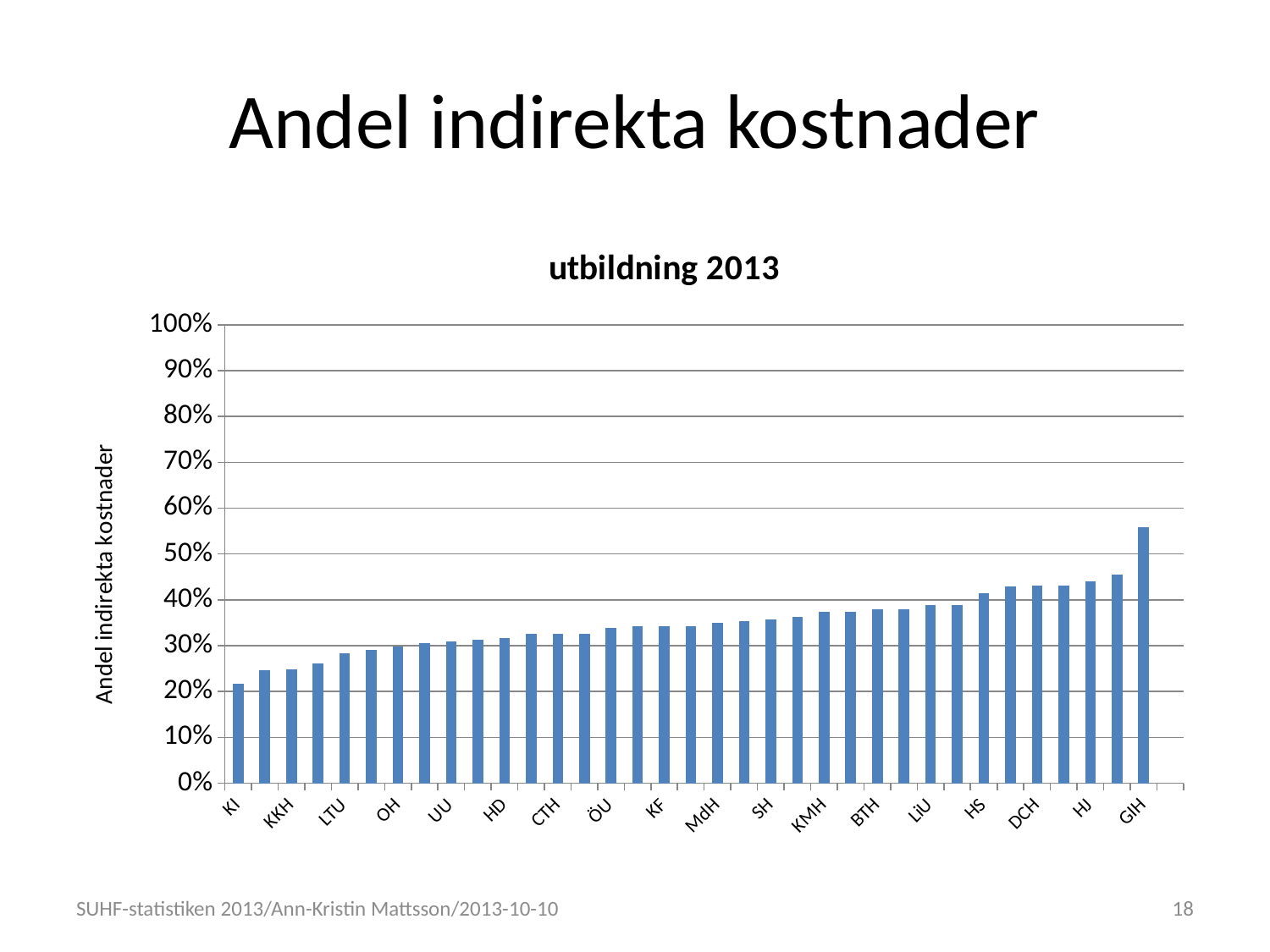
Is the value for GIH greater or less than 50%? greater Which category has the lowest value? KI Is the value for HJ greater or less than 40%? greater Is the value for KI greater or less than 30%? less Which is larger, the value for KKH or the value for DCH? DCH What is the title of the chart? utbildning 2013 What kind of chart is shown on the slide? bar chart What is the label of the vertical axis? Andel indirekta kostnader Do the values rise or fall from left to right along the x axis? rise Which is larger, the value for HS or the value for LTU? HS Which category has the highest value? GIH